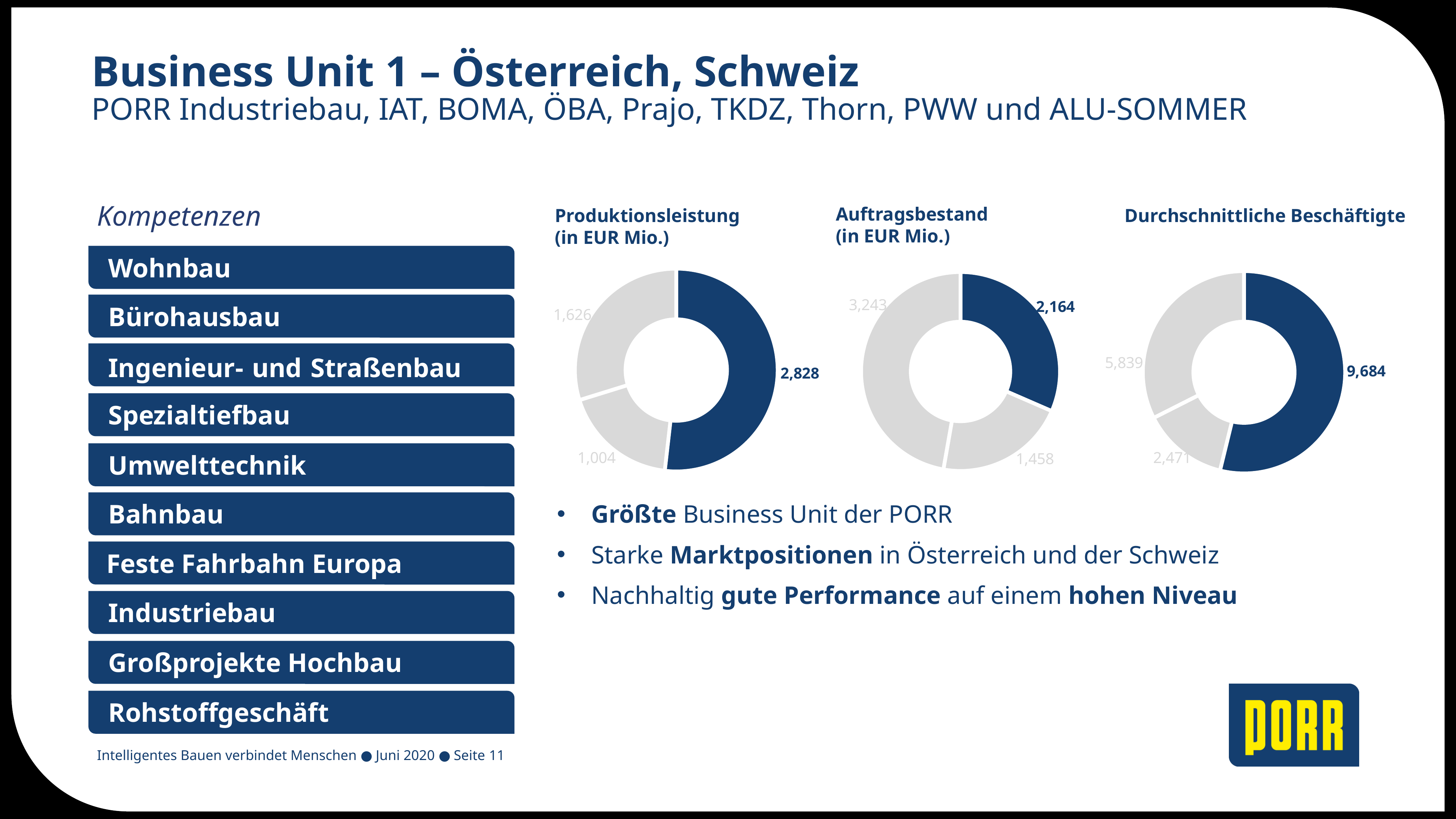
How many donut charts are shown on the slide? 3 In the Auftragsbestand (in EUR Mio.) chart, which is larger: the dark blue slice or the slice labelled 3,243? The slice labelled 3,243 In the Produktionsleistung (in EUR Mio.) chart, what is the difference between the dark blue slice (2,828) and the slice labelled 1,626? 1,202 In the Produktionsleistung (in EUR Mio.) chart, what is the smallest value shown? 1,004 What type of chart is used for Produktionsleistung (in EUR Mio.)? Donut (pie) chart What is the total of all three slices in the Durchschnittliche Beschäftigte chart? 17,994 In the Durchschnittliche Beschäftigte chart, what is the smallest value shown? 2,471 In the Auftragsbestand (in EUR Mio.) chart, what is the largest value shown? 3,243 How many slices does the Durchschnittliche Beschäftigte chart have? 3 In the Durchschnittliche Beschäftigte chart, what value is shown for the dark blue slice? 9,684 In the Auftragsbestand (in EUR Mio.) chart, what value is shown for the dark blue slice? 2,164 In the Produktionsleistung (in EUR Mio.) chart, what value is shown for the dark blue slice? 2,828